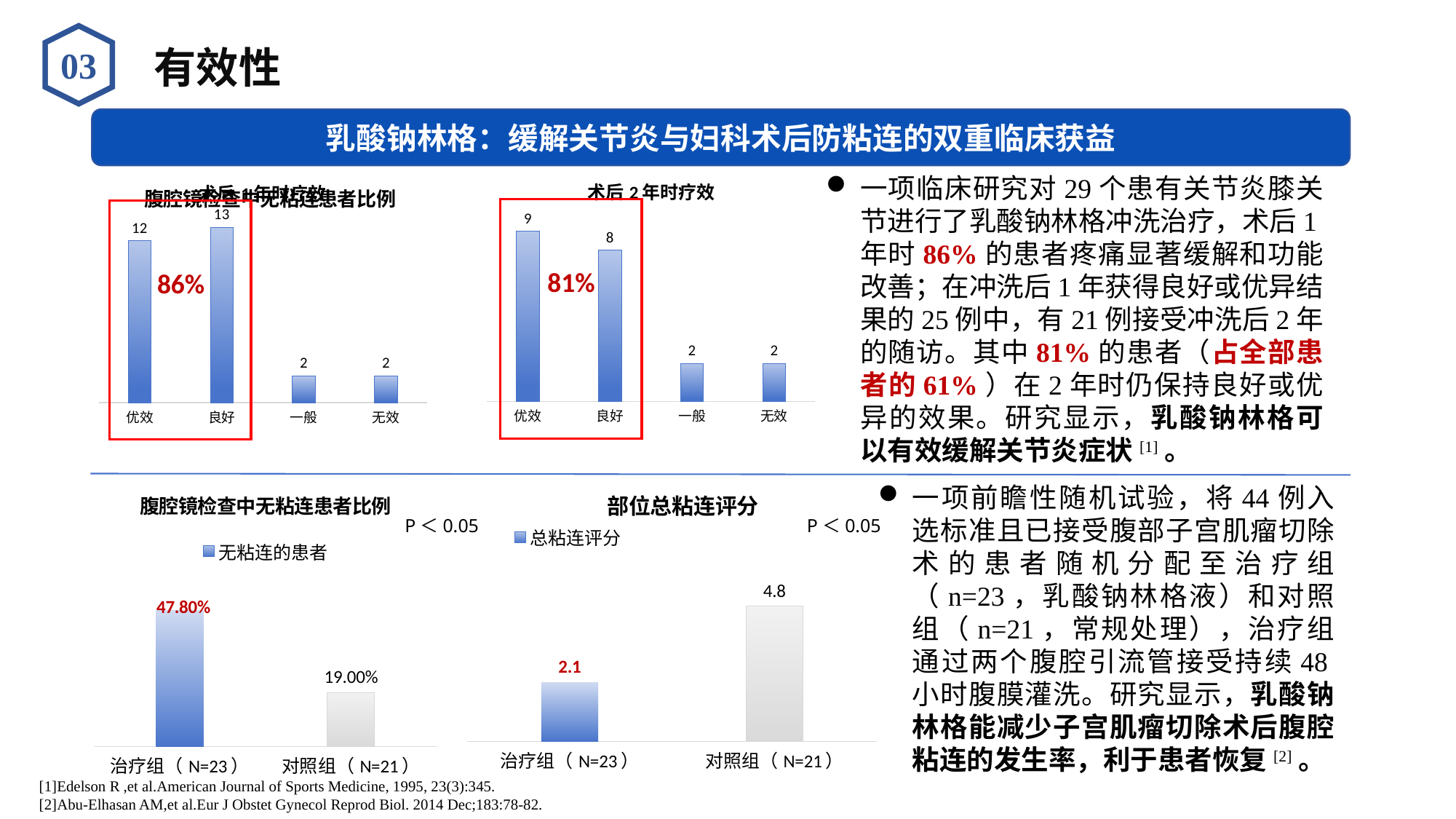
In the chart titled 腹腔镜检查中无粘连患者比例, what is the value for 治疗组 (N=23)? 47.80% In the chart titled 术后2年时疗效, which is larger, 优效 or 良好? 优效 In the top-left chart, what is the difference between the values for 优效 and 一般? 10 In the chart titled 部位总粘连评分, what is the difference between 对照组 (N=21) and 治疗组 (N=23)? 2.7 What type of chart is the chart titled 部位总粘连评分? Bar chart In the chart titled 术后2年时疗效, what is the value for 优效? 9 In the chart titled 部位总粘连评分, which group has the lowest value? 治疗组 (N=23) In the top-left chart, which category has the highest value? 良好 In the chart titled 腹腔镜检查中无粘连患者比例, what is the value for 对照组 (N=21)? 19.00% In the chart titled 术后2年时疗效, how many categories are shown on the x axis? 4 In the chart titled 部位总粘连评分, what is the value for 对照组 (N=21)? 4.8 In the top-left chart, what is the value for 良好? 13